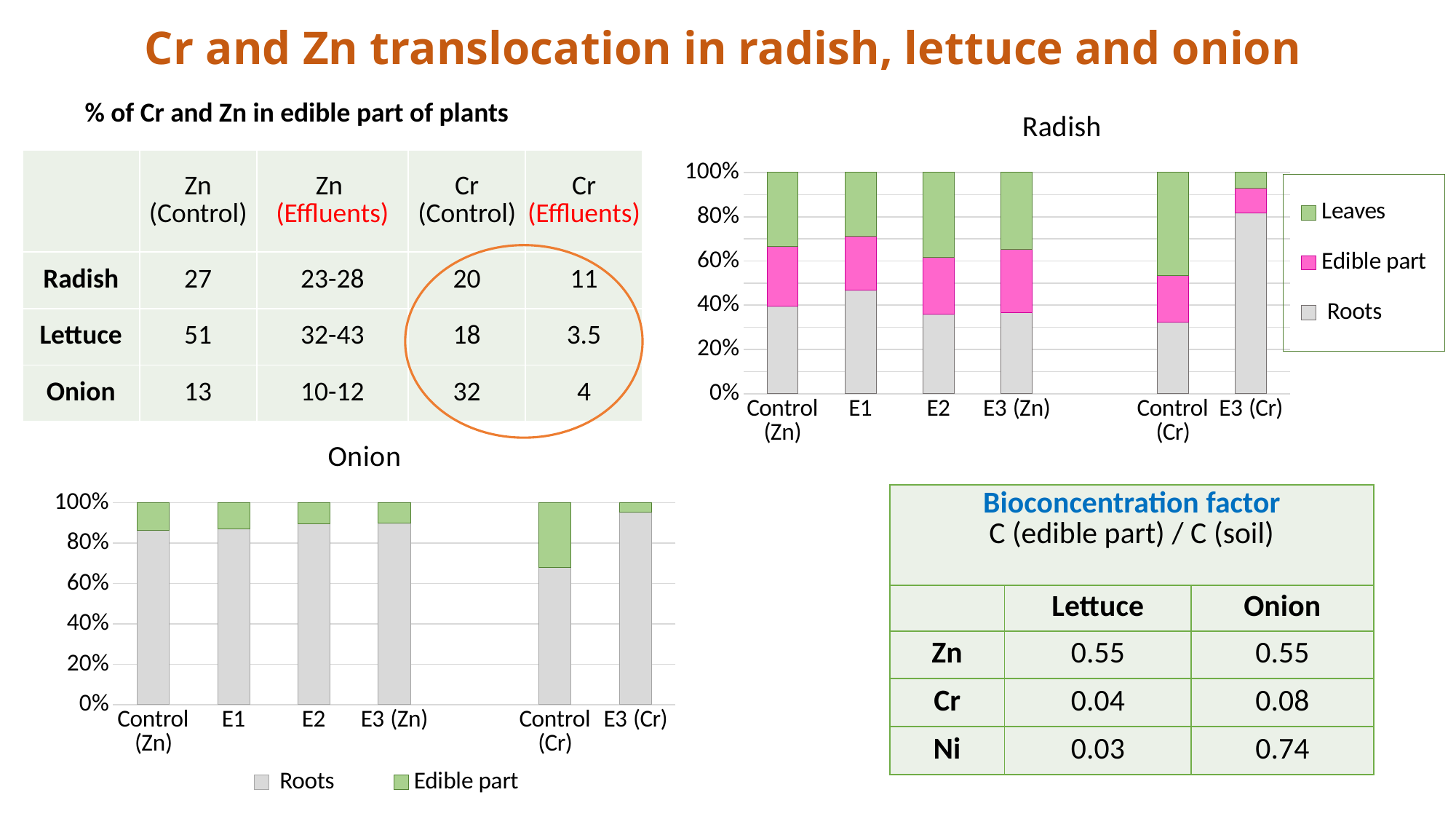
How many bars are plotted in the Onion chart? 6 In the Radish chart, is the Roots share for E3 (Cr) greater or less than 60%? greater In the Radish chart, is the Roots share for Control (Cr) greater or less than 40%? less What kind of chart is the Radish chart? stacked bar chart In the Onion chart, which category has the smallest Roots share? Control (Cr) In the Onion chart, is the Roots share for E3 (Cr) greater or less than 80%? greater In the Radish chart, which has the larger Roots share, Control (Cr) or E3 (Cr)? E3 (Cr) In the Radish chart, which category has the largest Roots share? E3 (Cr) How many series does the legend of the Onion chart list? 2 In the Radish chart, what colour represents the Edible part series? pink How many series does the legend of the Radish chart list? 3